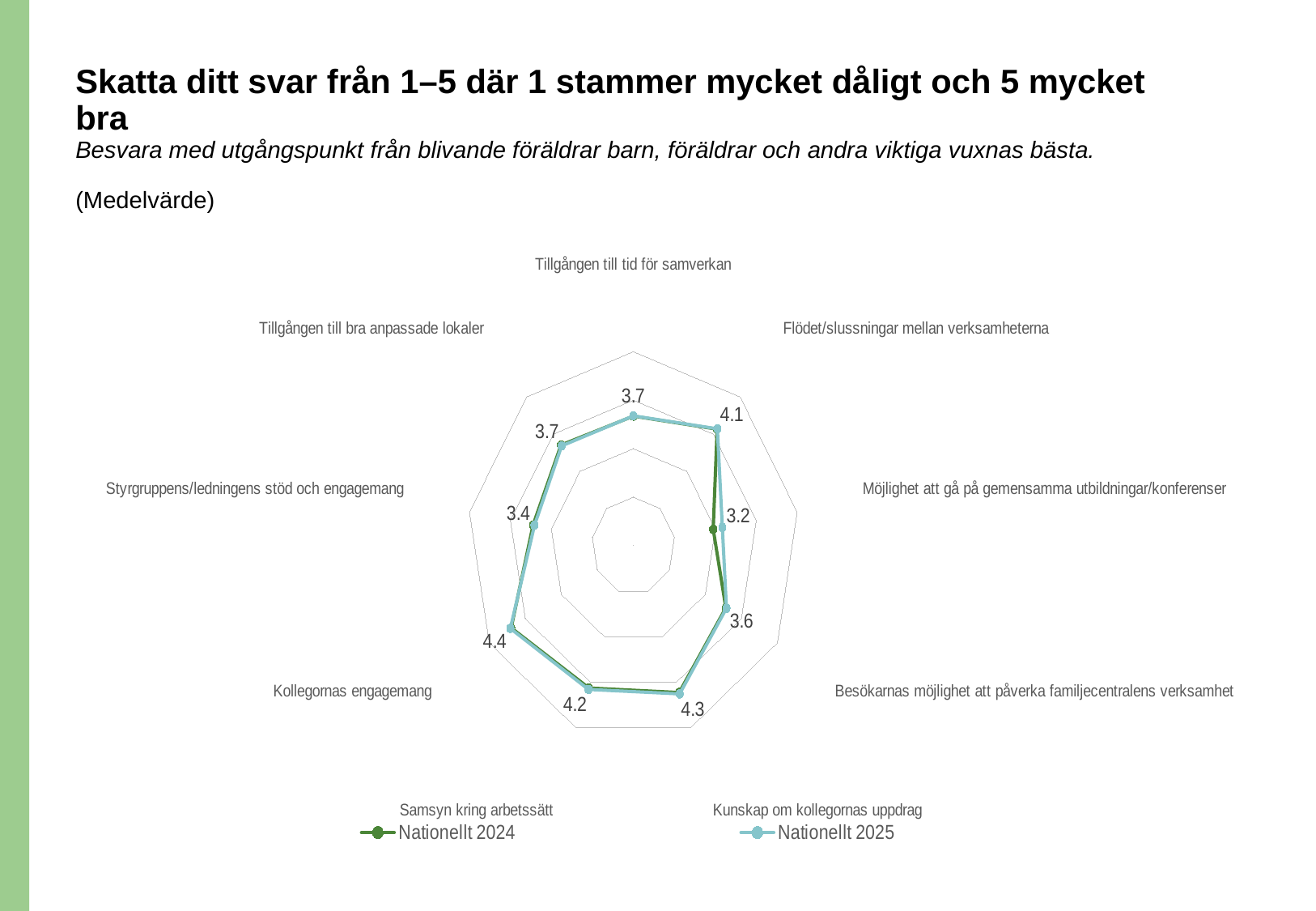
Which category has the lowest labelled value? Möjlighet att gå på gemensamma utbildningar/konferenser How many series does the legend list? 2 What value is labelled for Flödet/slussningar mellan verksamheterna? 4.1 What value is labelled for Möjlighet att gå på gemensamma utbildningar/konferenser? 3.2 How many categories (axes) does the radar chart have? 9 What value is labelled for Kollegornas engagemang? 4.4 What is the difference between the labelled values for Kollegornas engagemang and Möjlighet att gå på gemensamma utbildningar/konferenser? 1.2 What are the two series named in the legend? Nationellt 2024 and Nationellt 2025 Which category has the highest labelled value? Kollegornas engagemang Which has the larger labelled value, Kunskap om kollegornas uppdrag or Samsyn kring arbetssätt? Kunskap om kollegornas uppdrag What value is labelled for Styrgruppens/ledningens stöd och engagemang? 3.4 What kind of chart is shown on the slide? Radar chart